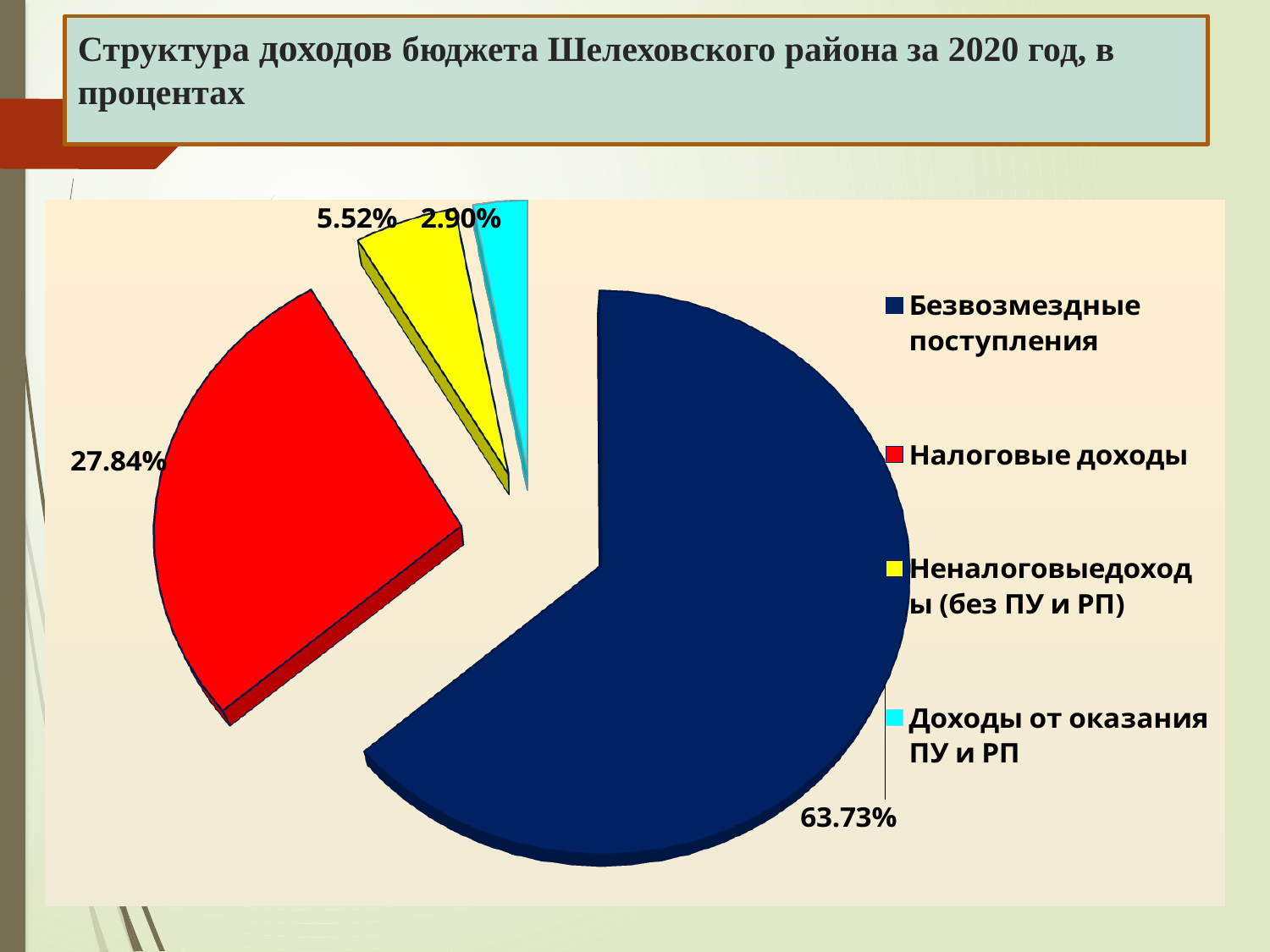
Which is larger, the share of Неналоговые доходы (без ПУ и РП) or the share of Доходы от оказания ПУ и РП? Неналоговые доходы (без ПУ и РП) What kind of chart is shown on the slide? pie chart Which category has the largest slice of the pie? Безвозмездные поступления What is the value shown for Налоговые доходы? 27.84% Which category has the smallest slice of the pie? Доходы от оказания ПУ и РП What is the value shown for Доходы от оказания ПУ и РП? 2.90% What colour is the slice for Налоговые доходы? red How many slices does the pie chart have? 4 What is the value shown for Неналоговые доходы (без ПУ и РП)? 5.52% What is the title of the slide containing the chart? Структура доходов бюджета Шелеховского района за 2020 год, в процентах What share of the pie does Безвозмездные поступления have? 63.73% What is the difference between the shares of Безвозмездные поступления and Налоговые доходы? 35.89%